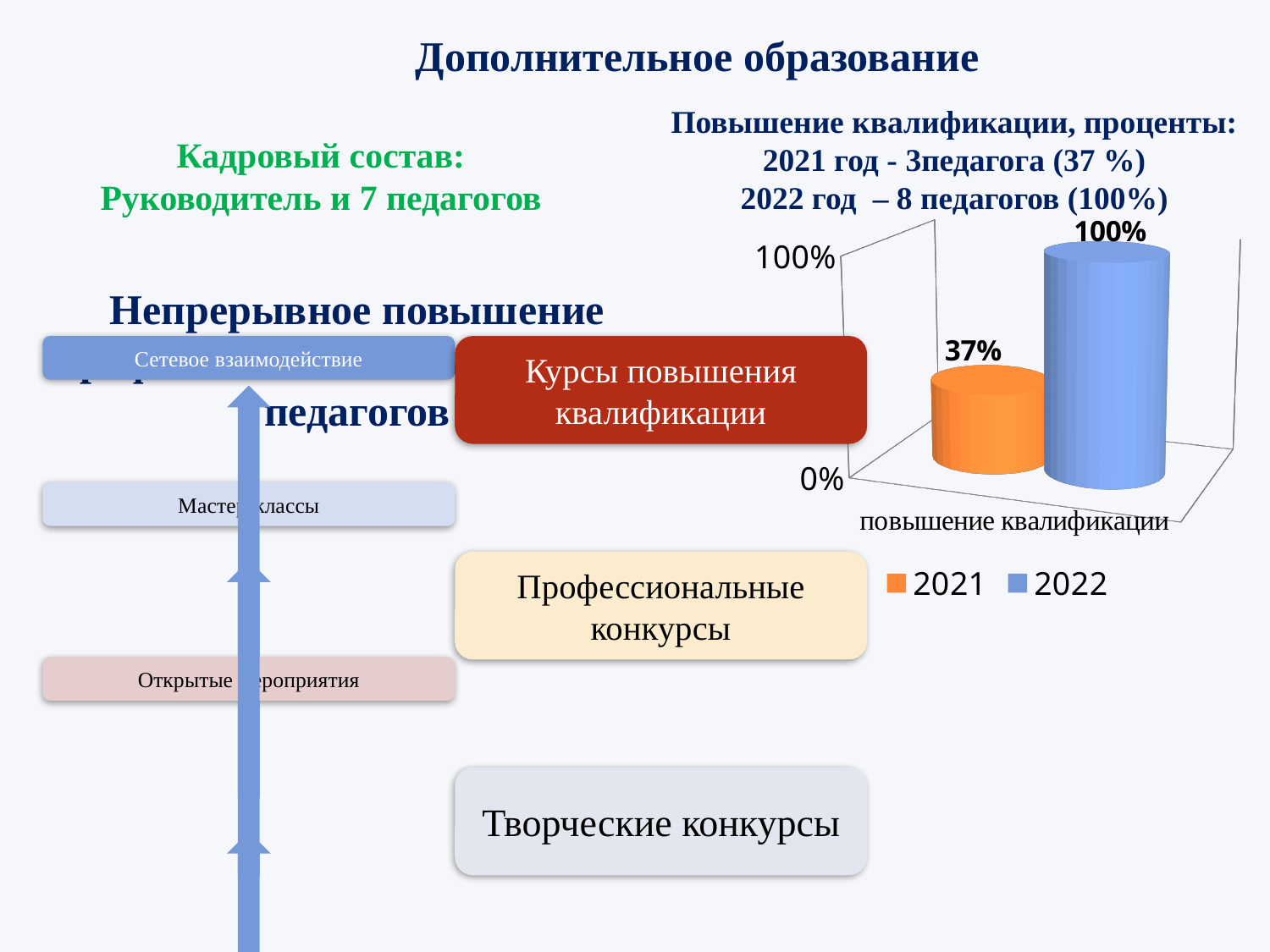
What is the value for the 2022 series in the chart? 100% What kind of chart is shown on the slide? bar chart How many categories are shown on the x axis of the chart? 1 What is the category label on the x axis of the chart? повышение квалификации How many series does the chart legend list? 2 Which series has the lowest value in the chart? 2021 What is the value for the 2021 series in the chart? 37% Which colour represents the 2021 series in the chart? orange What is the difference between the 2022 value and the 2021 value in the chart? 63% What is the highest tick value shown on the vertical axis of the chart? 100% Which series has the higher value in the chart, 2021 or 2022? 2022